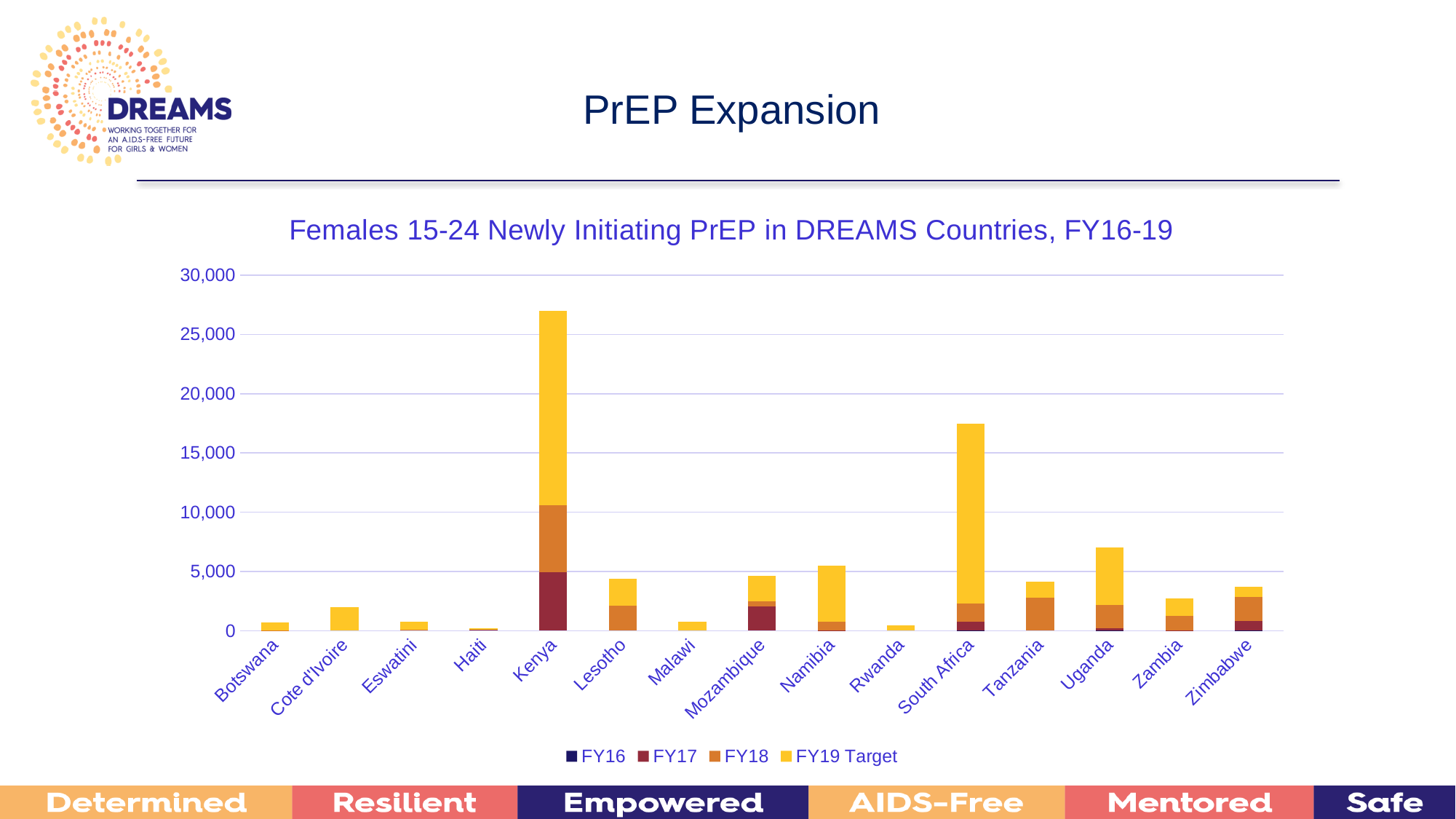
What kind of chart is shown on the slide? Stacked bar chart Is the total stacked bar for Lesotho greater or less than 5,000? less Is the total stacked bar for Kenya greater or less than 25,000? greater Which country has a taller stacked bar, Kenya or South Africa? Kenya Which series is shown in yellow in the legend? FY19 Target Which country has the tallest stacked bar? Kenya Is the total stacked bar for South Africa greater or less than 15,000? greater What is the title of the chart? Females 15-24 Newly Initiating PrEP in DREAMS Countries, FY16-19 How many countries are shown on the x axis of the chart? 15 Which country has the shortest stacked bar? Haiti How many series does the legend list? 4